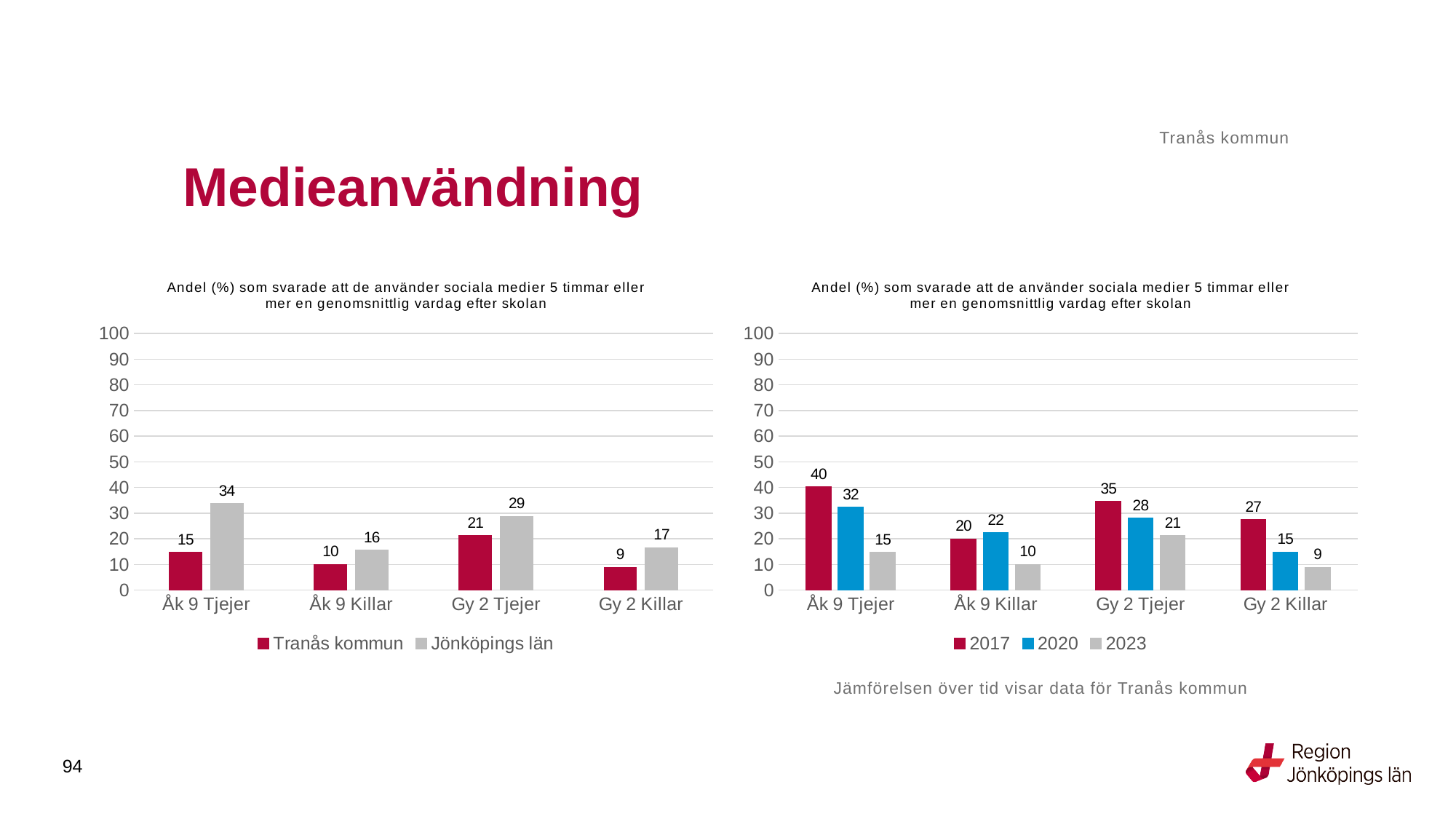
In the left chart, what is the value for Jönköpings län for Åk 9 Tjejer? 34 In the left chart, which category has the lowest value for Tranås kommun? Gy 2 Killar In the right chart, how does the value for Åk 9 Tjejer change from 2017 to 2023? It falls In the left chart, what is the value for Tranås kommun for Gy 2 Tjejer? 21 In the left chart, what is the difference between Jönköpings län and Tranås kommun for Åk 9 Tjejer? 19 In the right chart, what is the value for 2020 for Åk 9 Killar? 22 In the right chart, which category has the highest value for 2017? Åk 9 Tjejer In the right chart, which is larger for Gy 2 Tjejer: the 2017 value or the 2020 value? 2017 What kind of chart is the left chart? Bar chart How many categories are shown on the x axis of the right chart? 4 In the left chart, how many series does the legend list? 2 In the right chart, what is the difference between the 2017 and 2023 values for Gy 2 Killar? 18